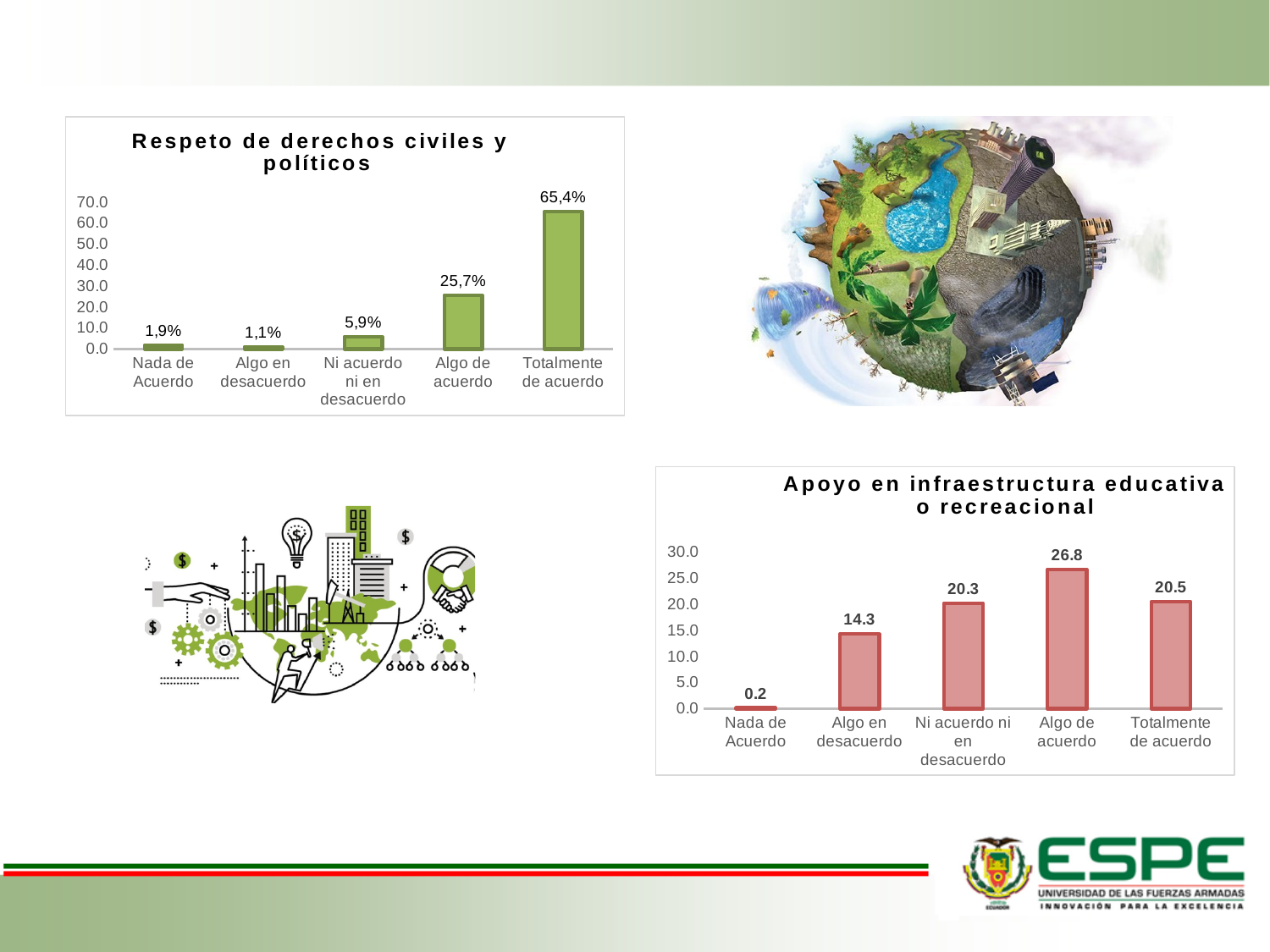
In the chart titled 'Apoyo en infraestructura educativa o recreacional', which category has the highest value? Algo de acuerdo In the chart titled 'Apoyo en infraestructura educativa o recreacional', what is the value for 'Nada de Acuerdo'? 0.2 In the chart titled 'Respeto de derechos civiles y políticos', what is the value for 'Algo de acuerdo'? 25,7% In the chart titled 'Respeto de derechos civiles y políticos', which category has the lowest value? Algo en desacuerdo In the chart titled 'Apoyo en infraestructura educativa o recreacional', what is the difference between 'Algo de acuerdo' and 'Algo en desacuerdo'? 12.5 What colour are the bars in the chart titled 'Respeto de derechos civiles y políticos'? Green In the chart titled 'Respeto de derechos civiles y políticos', what is the value for 'Totalmente de acuerdo'? 65,4% In the chart titled 'Apoyo en infraestructura educativa o recreacional', is the value for 'Ni acuerdo ni en desacuerdo' greater or less than 15.0? greater In the chart titled 'Respeto de derechos civiles y políticos', which is larger: 'Nada de Acuerdo' or 'Ni acuerdo ni en desacuerdo'? Ni acuerdo ni en desacuerdo In the chart titled 'Apoyo en infraestructura educativa o recreacional', what is the value for 'Algo de acuerdo'? 26.8 In the chart titled 'Respeto de derechos civiles y políticos', how many categories are shown on the x axis? 5 What kind of chart is the one titled 'Apoyo en infraestructura educativa o recreacional'? Bar chart